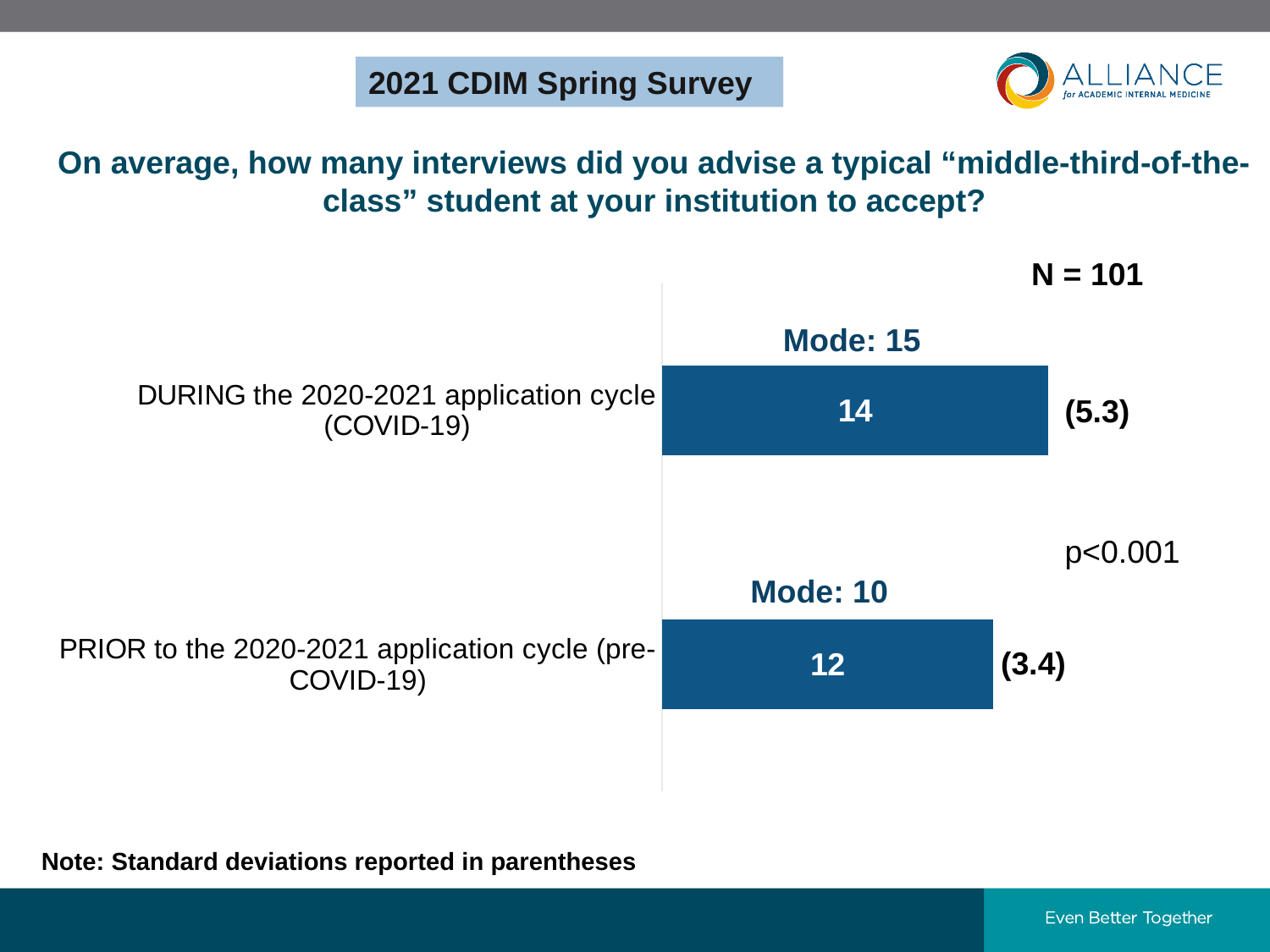
Which category has the higher value? DURING the 2020-2021 application cycle (COVID-19) What is the value for PRIOR to the 2020-2021 application cycle (pre-COVID-19)? 12 What standard deviation is reported for DURING the 2020-2021 application cycle (COVID-19)? 5.3 What is the mode reported for PRIOR to the 2020-2021 application cycle (pre-COVID-19)? 10 What is the difference between the DURING and PRIOR values? 2 How many categories are shown in the chart? 2 What kind of chart is shown on the slide? bar chart What is the sample size (N) shown on the chart? 101 Which category has the lower value? PRIOR to the 2020-2021 application cycle (pre-COVID-19) What is the mode reported for DURING the 2020-2021 application cycle (COVID-19)? 15 Is the value for DURING the 2020-2021 application cycle larger or smaller than the value for PRIOR to the 2020-2021 application cycle? larger What is the value for DURING the 2020-2021 application cycle (COVID-19)? 14